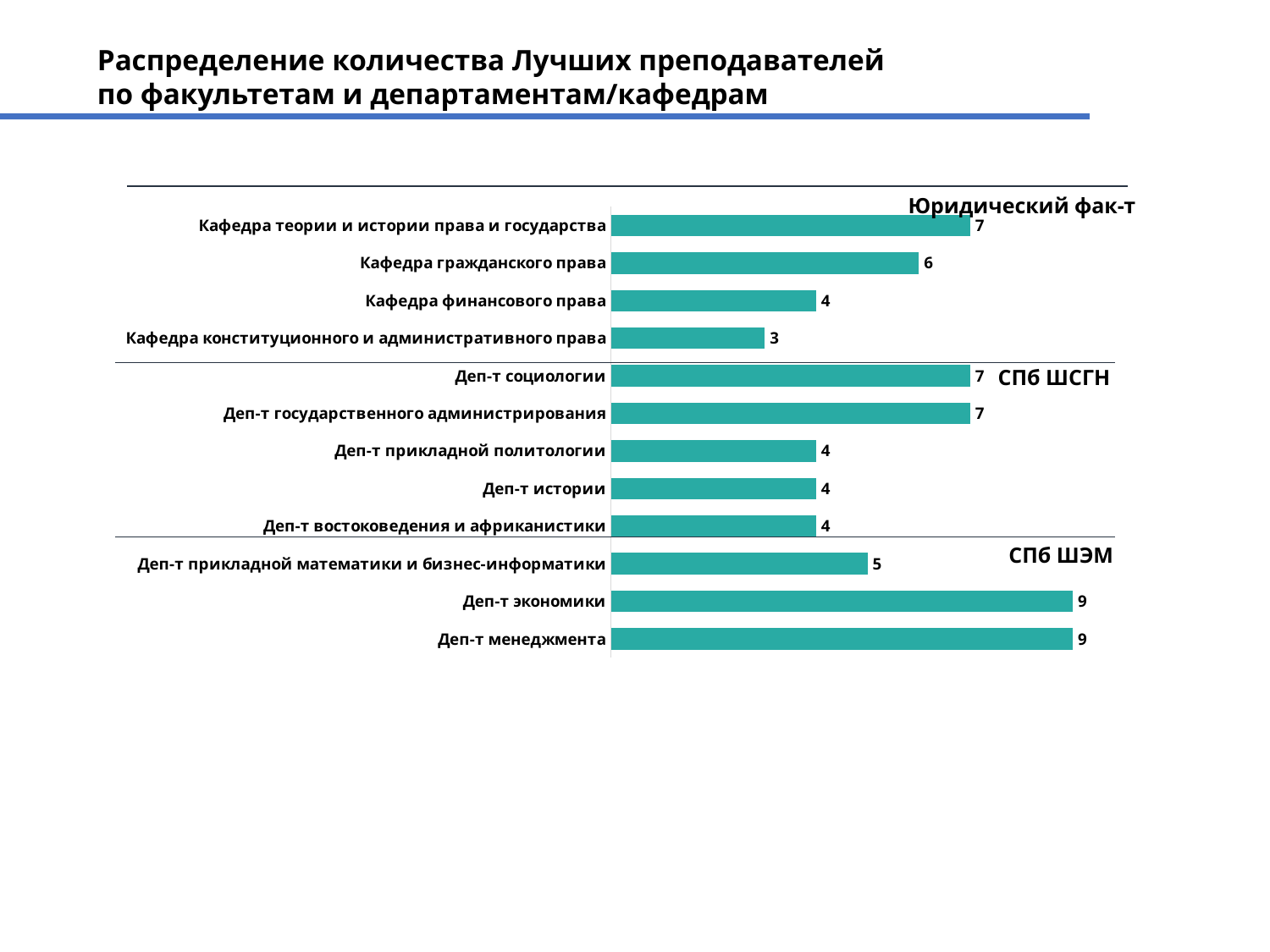
What is the difference between the value for Деп-т менеджмента and the value for Кафедра конституционного и административного права? 6 What is the difference between the value for Деп-т государственного администрирования and the value for Деп-т истории? 3 How many categories (departments/chairs) are plotted in the chart? 12 Which category has the lowest value in the chart? Кафедра конституционного и административного права What kind of chart is shown on the slide? bar chart What is the value for Деп-т социологии? 7 What is the highest value shown in the chart? 9 What is the value for Кафедра гражданского права? 6 What is the value for Деп-т прикладной математики и бизнес-информатики? 5 Which is larger: the value for Кафедра теории и истории права и государства or the value for Кафедра финансового права? Кафедра теории и истории права и государства Which three faculty/school groups are labelled on the chart? Юридический фак-т, СПб ШСГН, СПб ШЭМ What is the value for Деп-т экономики? 9